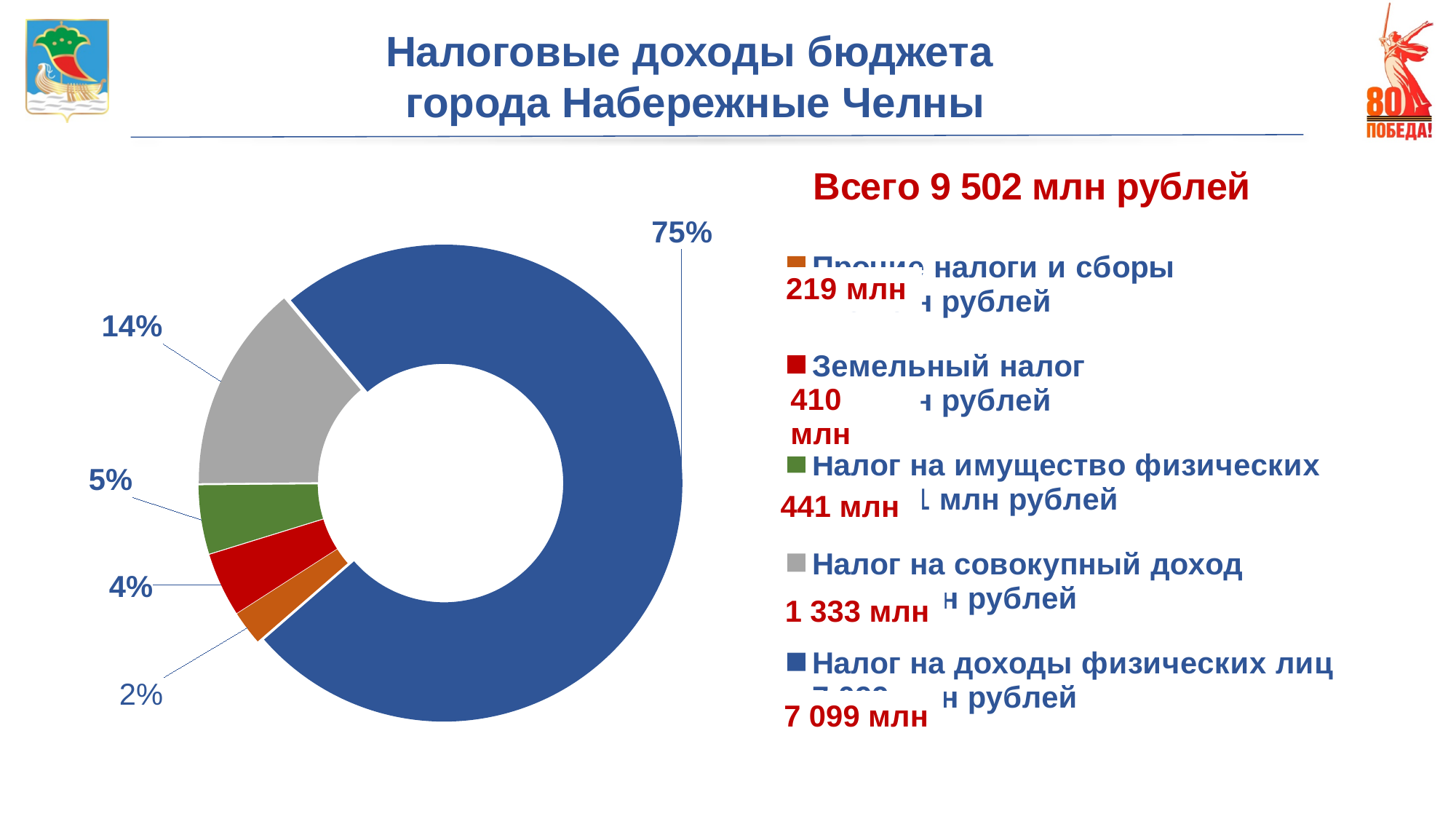
Какой источник налоговых доходов является наименьшим? Прочие налоги и сборы Какую долю составляют прочие налоги и сборы? 2% Какую долю составляет налог на совокупный доход? 14% Что больше: земельный налог или налог на имущество физических лиц? Налог на имущество физических лиц Какую долю составляет земельный налог? 4% Сколько категорий налоговых доходов показано на диаграмме? 5 Какой источник налоговых доходов является наибольшим? Налог на доходы физических лиц Какая сумма указана для налога на совокупный доход? 1 333 млн На сколько млн рублей налог на совокупный доход больше земельного налога? 923 млн Какая сумма указана для налога на имущество физических лиц? 441 млн Какой тип диаграммы показан на слайде? кольцевая (круговая) диаграмма